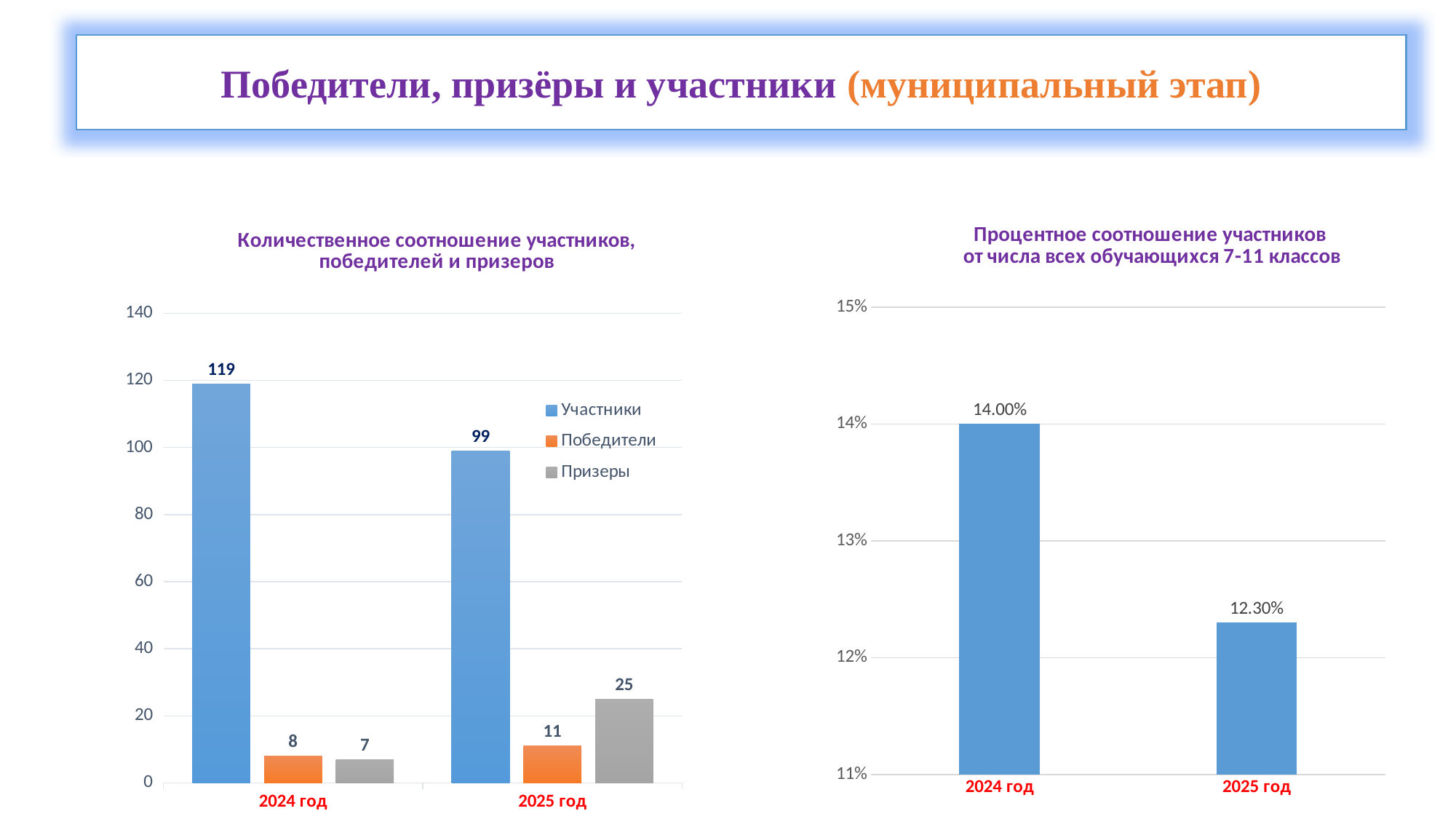
In the left chart, which is larger: Призеры in 2024 год or Призеры in 2025 год? 2025 год In the left chart, what is the value for Победители in 2024 год? 8 In the left chart, what is the total of Участники, Победители and Призеры for 2025 год? 135 In the right chart, what is the value for 2025 год? 12.30% What kind of chart is the right chart? bar chart In the left chart, what is the value for Призеры in 2025 год? 25 In the left chart, how many year categories are shown on the x axis? 2 In the left chart, what is the difference between Участники in 2024 год and Участники in 2025 год? 20 In the right chart, do the values rise or fall from 2024 год to 2025 год? fall In the right chart (Процентное соотношение участников от числа всех обучающихся 7-11 классов), what is the value for 2024 год? 14.00% In the left chart (Количественное соотношение участников, победителей и призеров), what is the value for Участники in 2024 год? 119 In the left chart, how many series does the legend list? 3